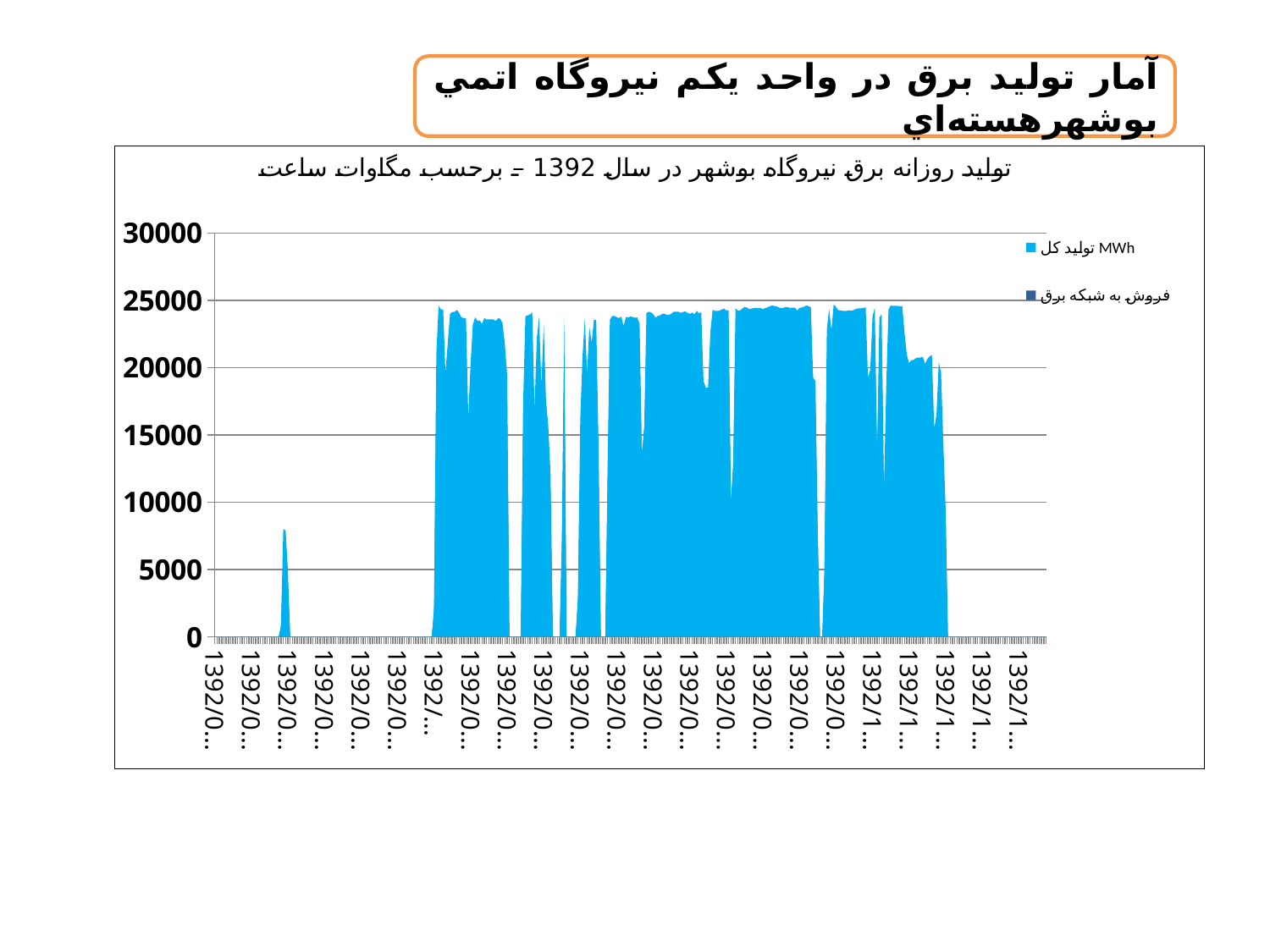
Is the highest value plotted on the chart greater or less than 20000? greater Is the highest value plotted on the chart greater or less than 30000? less What is the first entry in the chart's legend? MWh تولید کل What is the title of the chart? تولید روزانه برق نیروگاه بوشهر در سال 1392 - برحسب مگاوات ساعت What kind of chart is shown on the slide? area chart Is the small isolated spike near the start of the year greater or less than 5000? greater How many series does the legend list? 2